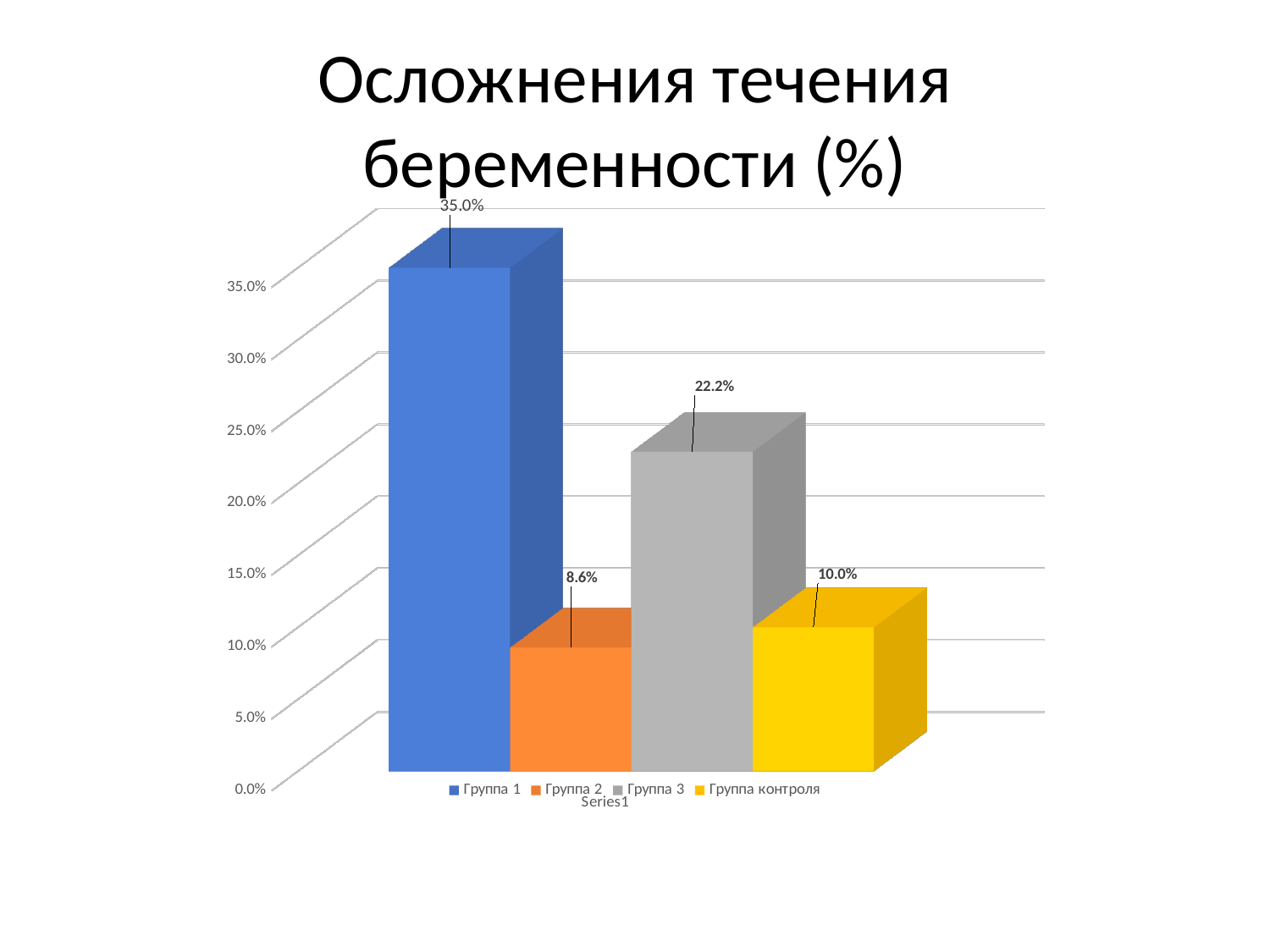
What is the value for Группа 1? 35.0% What is the difference between the values for Группа контроля and Группа 2? 1.4% What is the value for Группа контроля? 10.0% What is the difference between the values for Группа 1 and Группа 3? 12.8% What kind of chart is shown on the slide? Bar chart Which group has the highest value? Группа 1 What is the value for Группа 3? 22.2% What is the value for Группа 2? 8.6% How many series does the legend list? 4 Which group has the lowest value? Группа 2 What is the title of the chart? Осложнения течения беременности (%) Which is larger, the value for Группа 3 or the value for Группа контроля? Группа 3